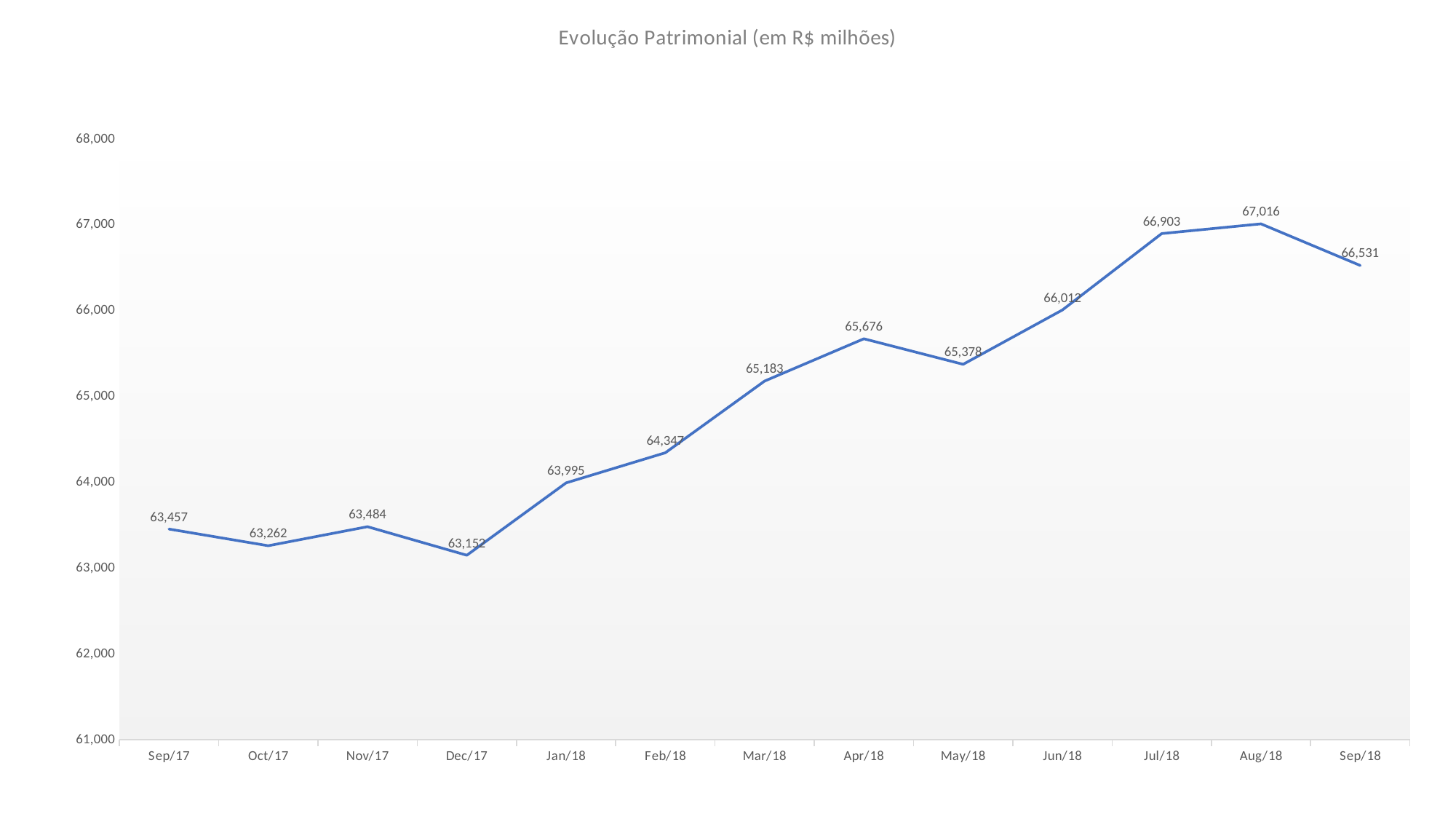
What is the title of the chart? Evolução Patrimonial (em R$ milhões) What is the difference between the values for Aug/18 and Sep/18? 485 What is the value for Apr/18? 65,676 Which month has the lowest value? Dec/17 What is the value for Sep/17? 63,457 Is the value for Jun/18 greater or less than 66,000? greater Which is larger, the value for Nov/17 or the value for Oct/17? Nov/17 What is the value for Sep/18? 66,531 What kind of chart is shown? line chart Which month has the highest value? Aug/18 What is the difference between the values for Jan/18 and Dec/17? 843 How many months are plotted on the chart? 13